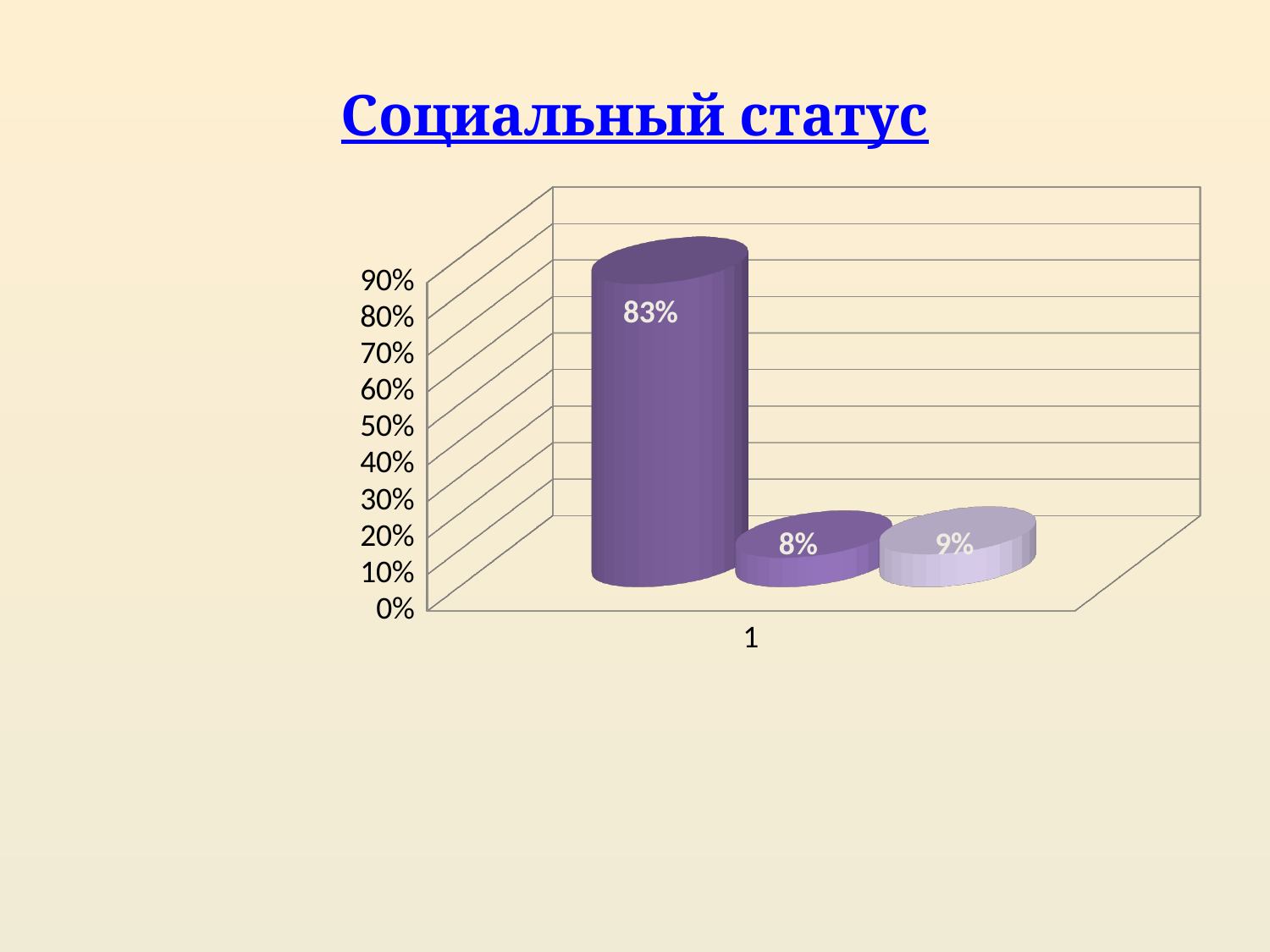
What is the title of the slide above the chart? Социальный статус How many bars are plotted on the chart? 3 What kind of chart is shown on the slide? Bar chart What value is shown on the rightmost (light lavender) bar? 9% Which is larger, the middle bar or the rightmost bar? The rightmost bar (9%) What is the total of the three values shown on the bars? 100% Which bar has the lowest value? The middle bar (8%) Is the value of the leftmost bar greater or less than 50%? greater What is the difference between the leftmost bar (83%) and the middle bar (8%)? 75% Which bar has the highest value? The leftmost bar (83%) What value is shown on the middle bar? 8% What value is shown on the tallest (leftmost, dark purple) bar? 83%